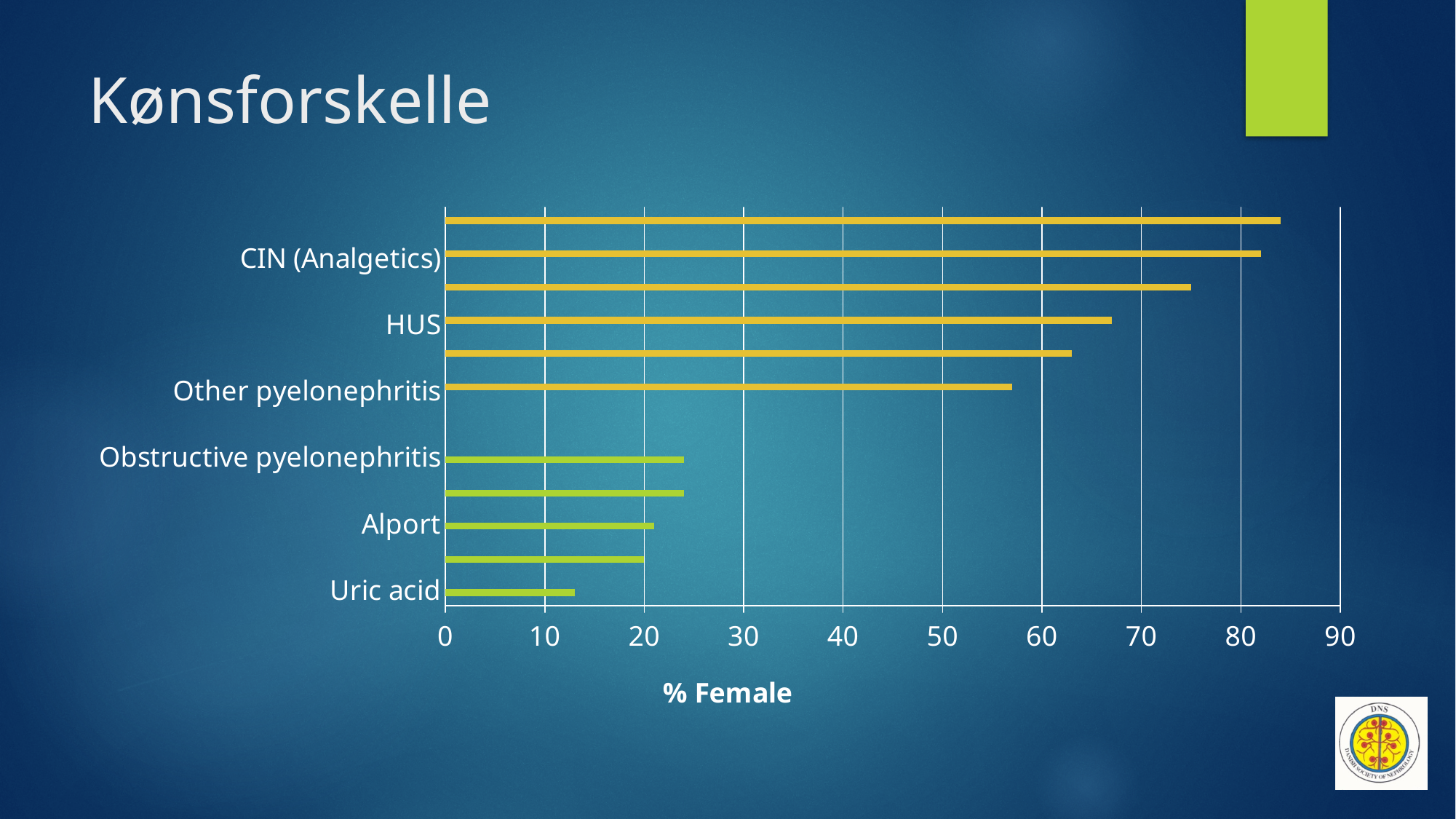
What kind of chart is shown on the slide? bar chart Is the value for Uric acid greater or less than 20? less Among the labeled categories, which has the highest % Female? CIN (Analgetics) Is the value for Other pyelonephritis greater or less than 60? less Is the value for HUS greater or less than 60? greater What is the title of the slide containing the chart? Kønsforskelle Which has a higher % Female, Alport or Uric acid? Alport What is the label on the horizontal axis of the chart? % Female Which has a higher % Female, CIN (Analgetics) or HUS? CIN (Analgetics) Which labeled category has the lowest % Female? Uric acid